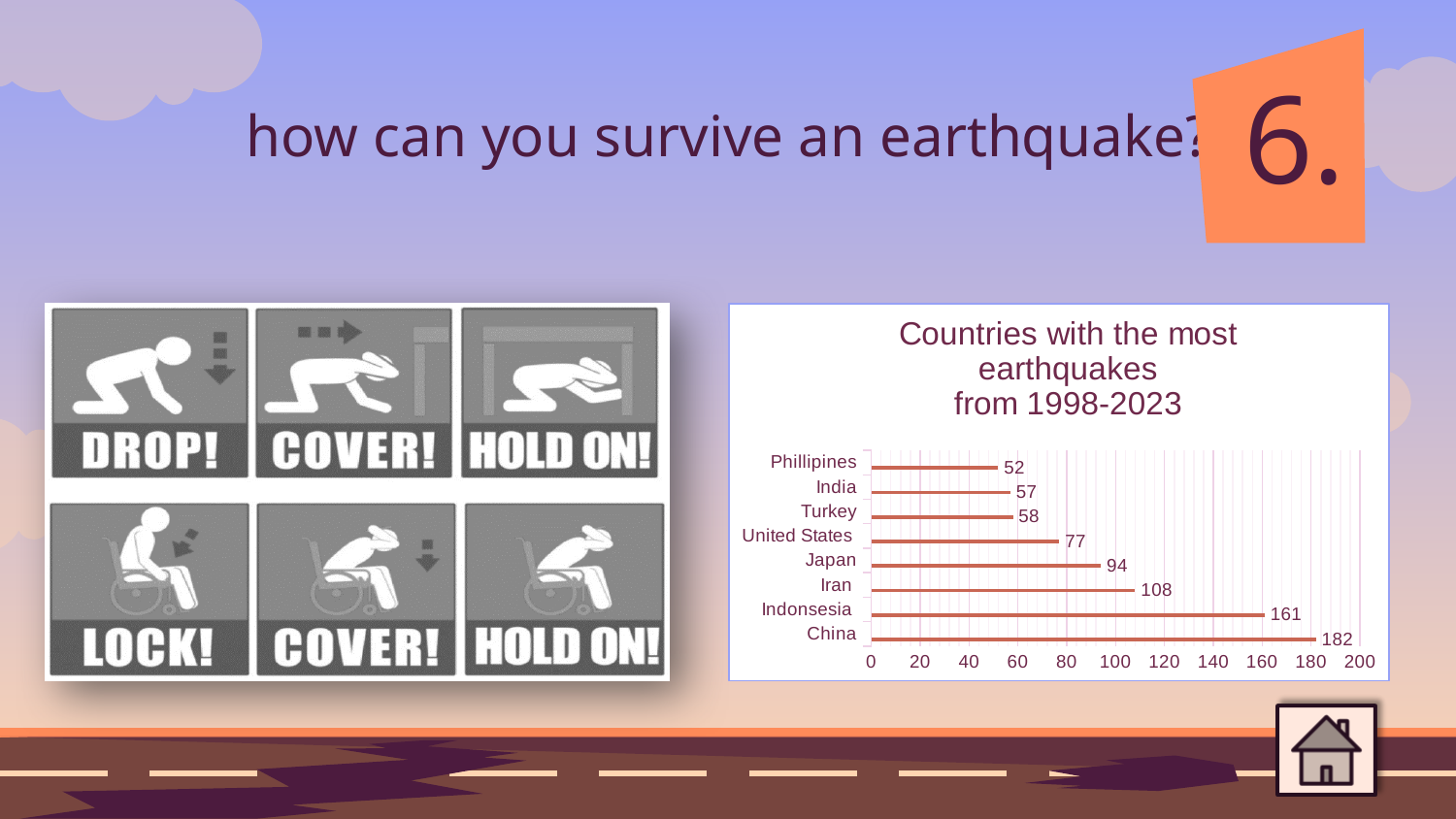
What is the difference between the values for China and Indonsesia? 21 Which country has the lowest value? Phillipines What is the title of the chart? Countries with the most earthquakes from 1998-2023 What is the value for China? 182 Which country has the highest value? China Is the value for Indonsesia greater or less than 140? greater What is the difference between the values for India and Phillipines? 5 What is the value for Japan? 94 What kind of chart is shown? bar chart Which has a larger value, Iran or United States? Iran What is the value for Turkey? 58 How many countries are shown in the chart? 8